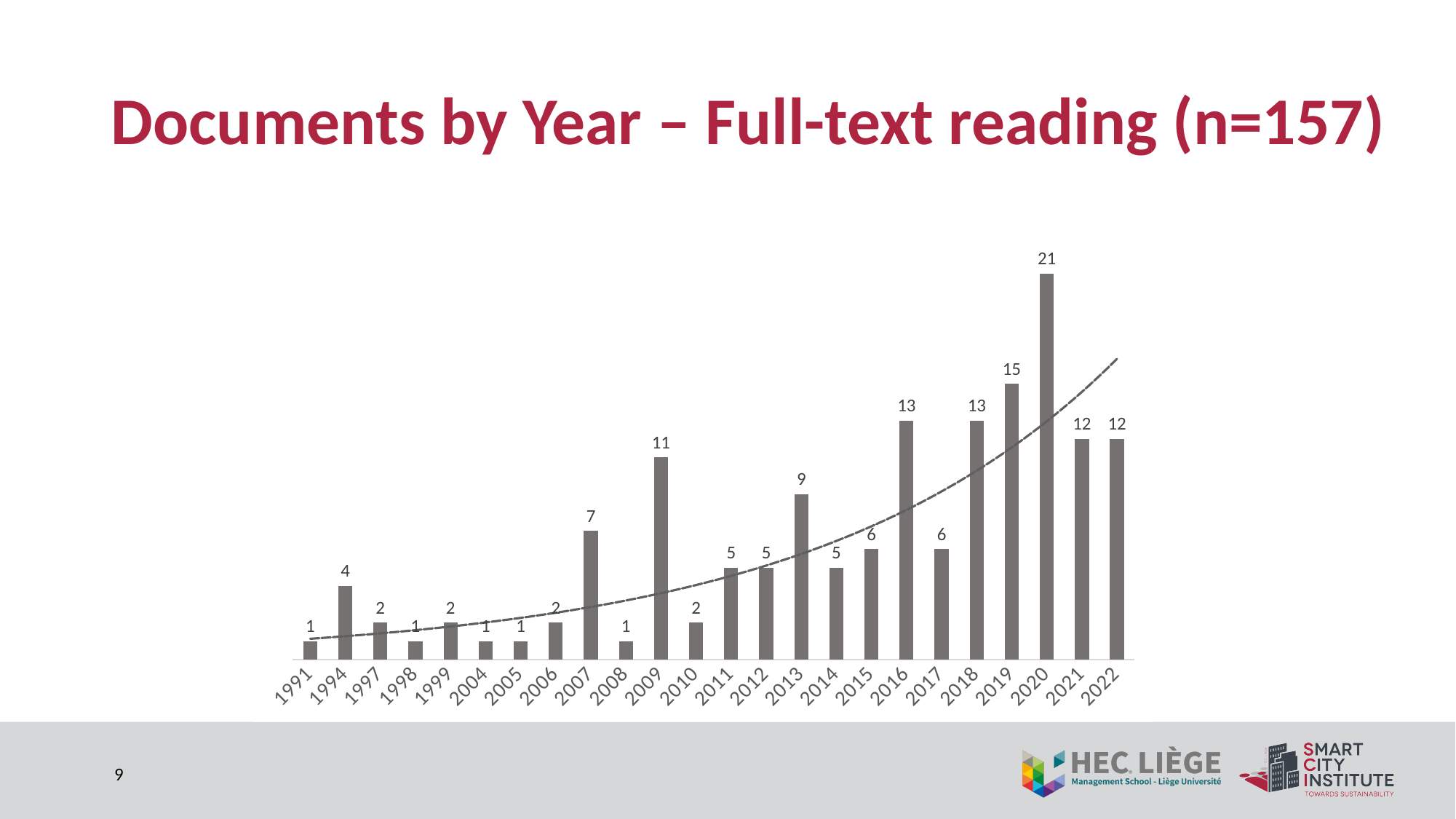
What is the title of the chart on the slide? Documents by Year – Full-text reading (n=157) Do the values generally rise or fall from 1991 to 2020? Rise What is the value for 2009? 11 Which year has the larger value, 2014 or 2015? 2015 What kind of chart is shown on the slide? Bar chart Which year has the highest number of documents? 2020 Which year has the larger value, 2007 or 2011? 2007 How many years are shown on the x axis? 24 What is the difference between the values for 2016 and 2017? 7 What is the value for 2013? 9 What is the difference between the values for 2020 and 2019? 6 How many documents are shown for 2020? 21